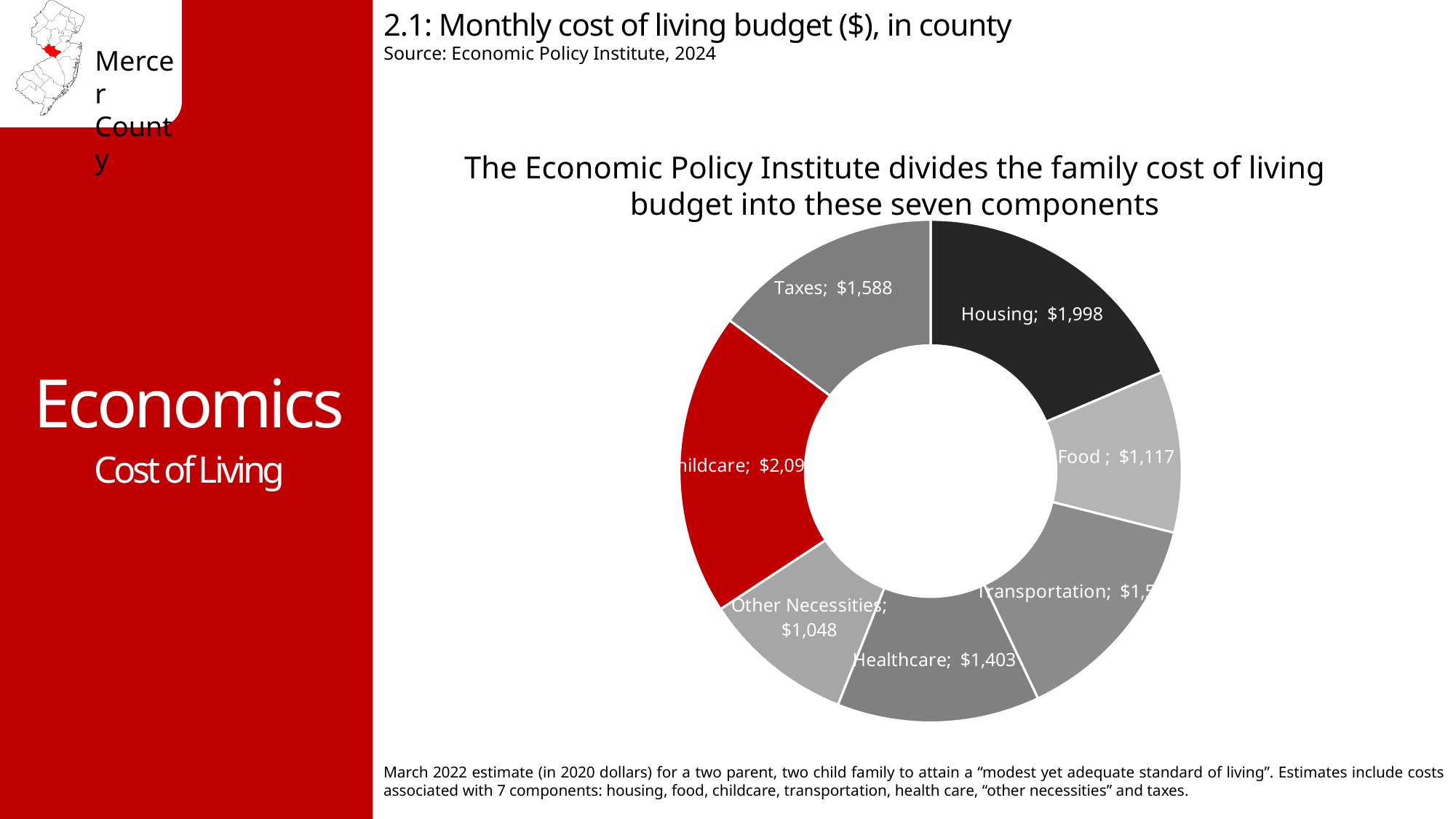
What is the monthly cost for Food? $1,117 Which is larger, the Taxes cost or the Healthcare cost? Taxes How many components (slices) does the chart show? 7 What type of chart is shown on the slide? Doughnut (pie) chart What is the monthly cost for Healthcare? $1,403 What is the monthly cost for Other Necessities? $1,048 What is the difference between the Housing cost and the Food cost? $881 What is the monthly cost for Housing? $1,998 Which component has the largest monthly cost? Childcare What is the source cited for the chart? Economic Policy Institute, 2024 What is the monthly cost for Taxes? $1,588 Which component has the smallest monthly cost? Other Necessities